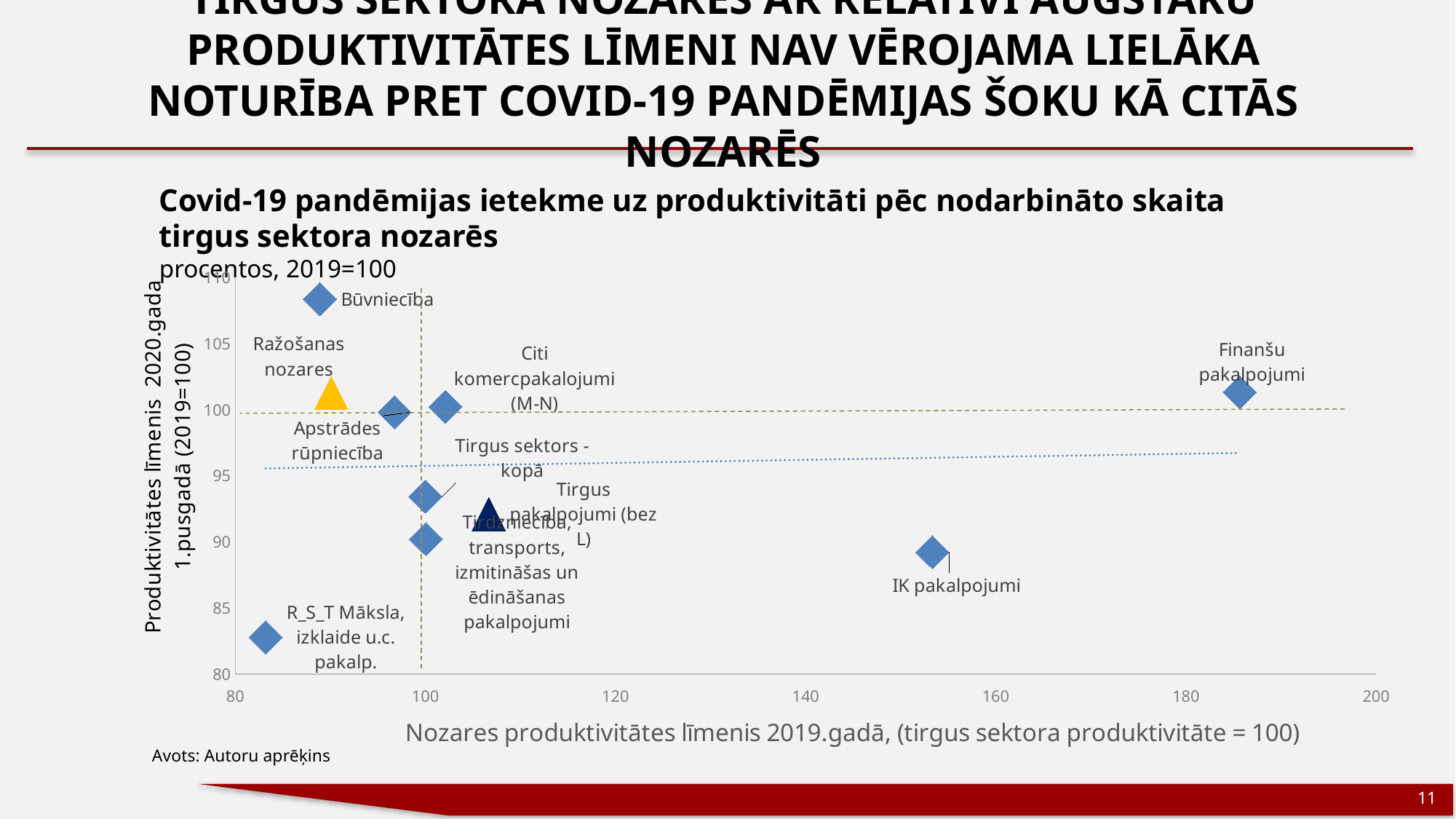
Which has the higher vertical-axis value, IK pakalpojumi or Finanšu pakalpojumi? Finanšu pakalpojumi What kind of chart is shown on the slide? scatter chart Is the vertical-axis value for Būvniecība greater or less than 105? greater Which sector has the lowest productivity level in the first half of 2020 (vertical axis)? R_S_T Māksla, izklaide u.c. pakalp. How many labelled data points are plotted on the chart? 10 Which has the higher vertical-axis value, Būvniecība or Apstrādes rūpniecība? Būvniecība Is the vertical-axis value for R_S_T Māksla, izklaide u.c. pakalp. greater or less than 85? less Which sector has the highest productivity level in the first half of 2020 (vertical axis)? Būvniecība What is the title of the horizontal axis? Nozares produktivitātes līmenis 2019.gadā, (tirgus sektora produktivitāte = 100) Is the horizontal-axis value for Finanšu pakalpojumi greater or less than 180? greater Which sector has the highest productivity level in 2019 (horizontal axis)? Finanšu pakalpojumi